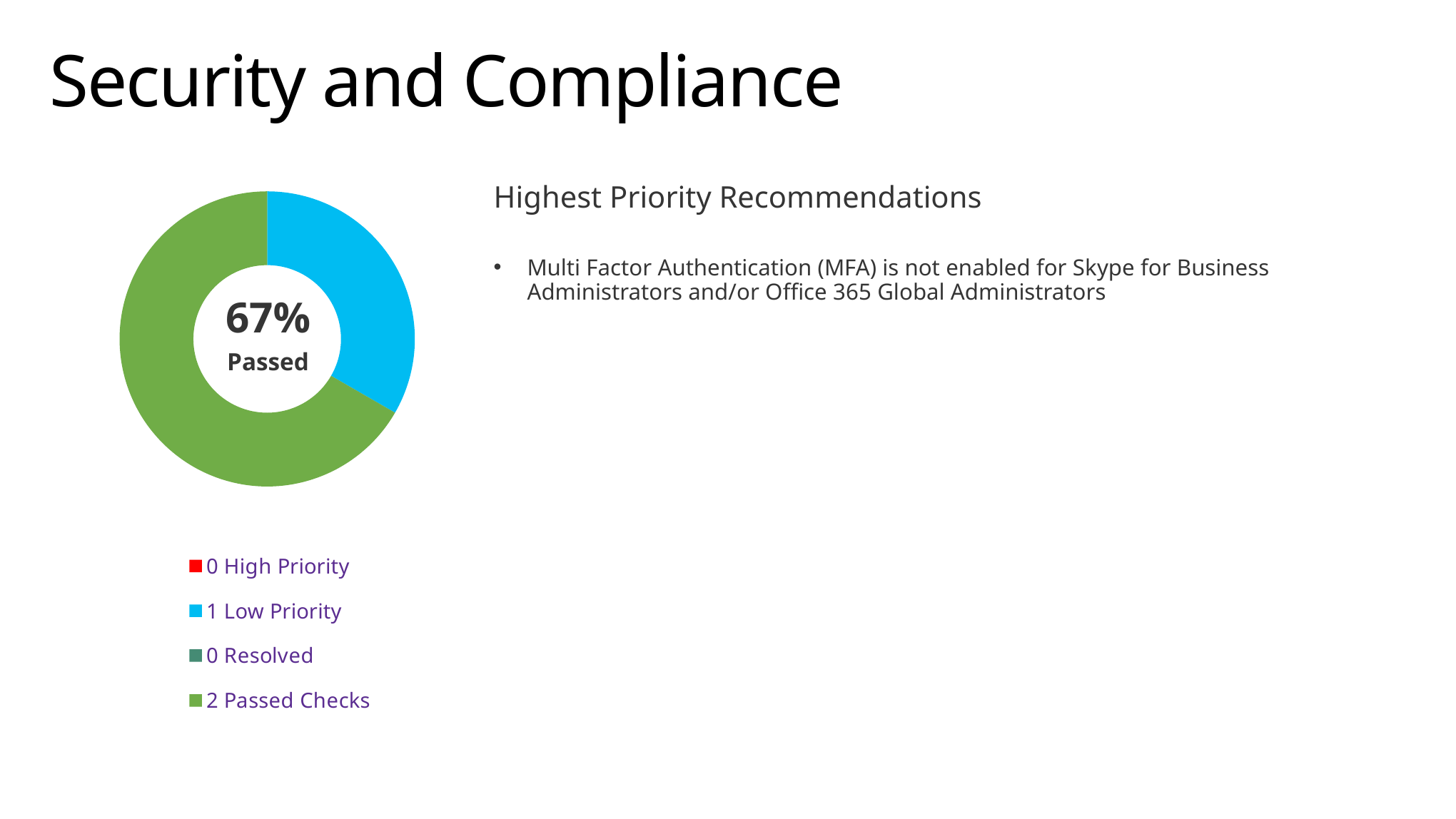
How many Resolved items does the chart report? 0 How many Passed Checks does the chart report? 2 How many categories does the chart's legend list? 4 What colour is the Passed Checks slice of the chart? green What percentage is printed in the centre of the chart? 67% Which legend category has the highest count? Passed Checks What is the total of all the counts listed in the legend? 3 Which is larger, the count of Passed Checks or the count of Low Priority items? Passed Checks How many High Priority items does the chart report? 0 How many Low Priority items does the chart report? 1 What kind of chart is shown on the slide? doughnut chart What is the difference between the number of Passed Checks and the number of Low Priority items? 1